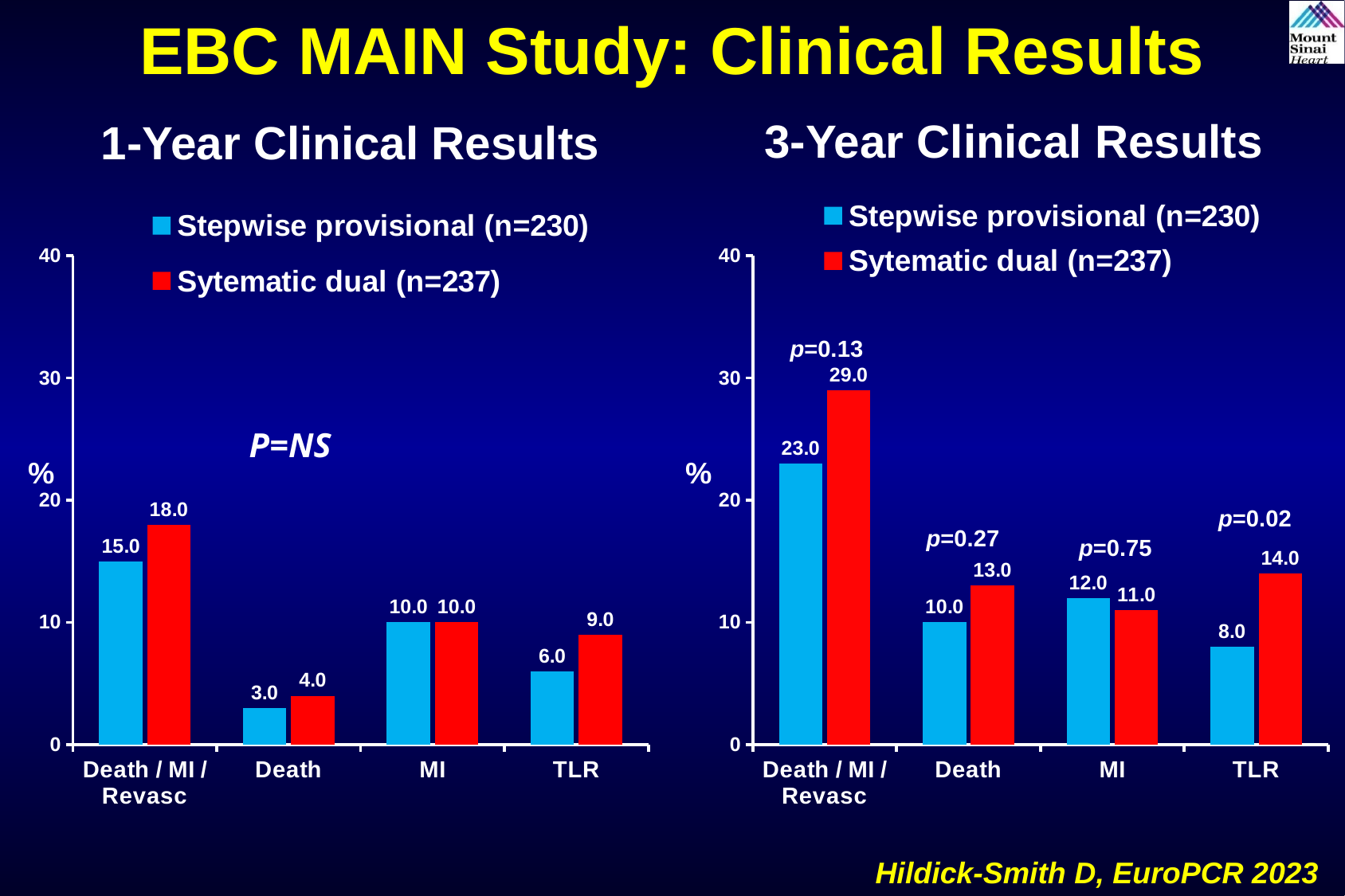
In the 3-Year Clinical Results chart, what is the difference between the Sytematic dual and Stepwise provisional values for Death / MI / Revasc? 6.0 In the 3-Year Clinical Results chart, what p-value is shown above the TLR bars? p=0.02 In the 1-Year Clinical Results chart, what is the value for Stepwise provisional for Death / MI / Revasc? 15.0 In the 3-Year Clinical Results chart, which is larger for MI: Stepwise provisional or Sytematic dual? Stepwise provisional How many categories are shown on the x axis of the 1-Year Clinical Results chart? 4 In the 3-Year Clinical Results chart, what is the value for Sytematic dual for TLR? 14.0 In the 3-Year Clinical Results chart, which category has the highest Sytematic dual value? Death / MI / Revasc How many series does the legend of the 3-Year Clinical Results chart list? 2 In the 1-Year Clinical Results chart, which category has the lowest Stepwise provisional value? Death What kind of chart is the 1-Year Clinical Results chart? Bar chart In the 1-Year Clinical Results chart, what is the difference between the Sytematic dual and Stepwise provisional values for TLR? 3.0 In the 3-Year Clinical Results chart, is the Sytematic dual value for Death / MI / Revasc greater or less than 20? greater